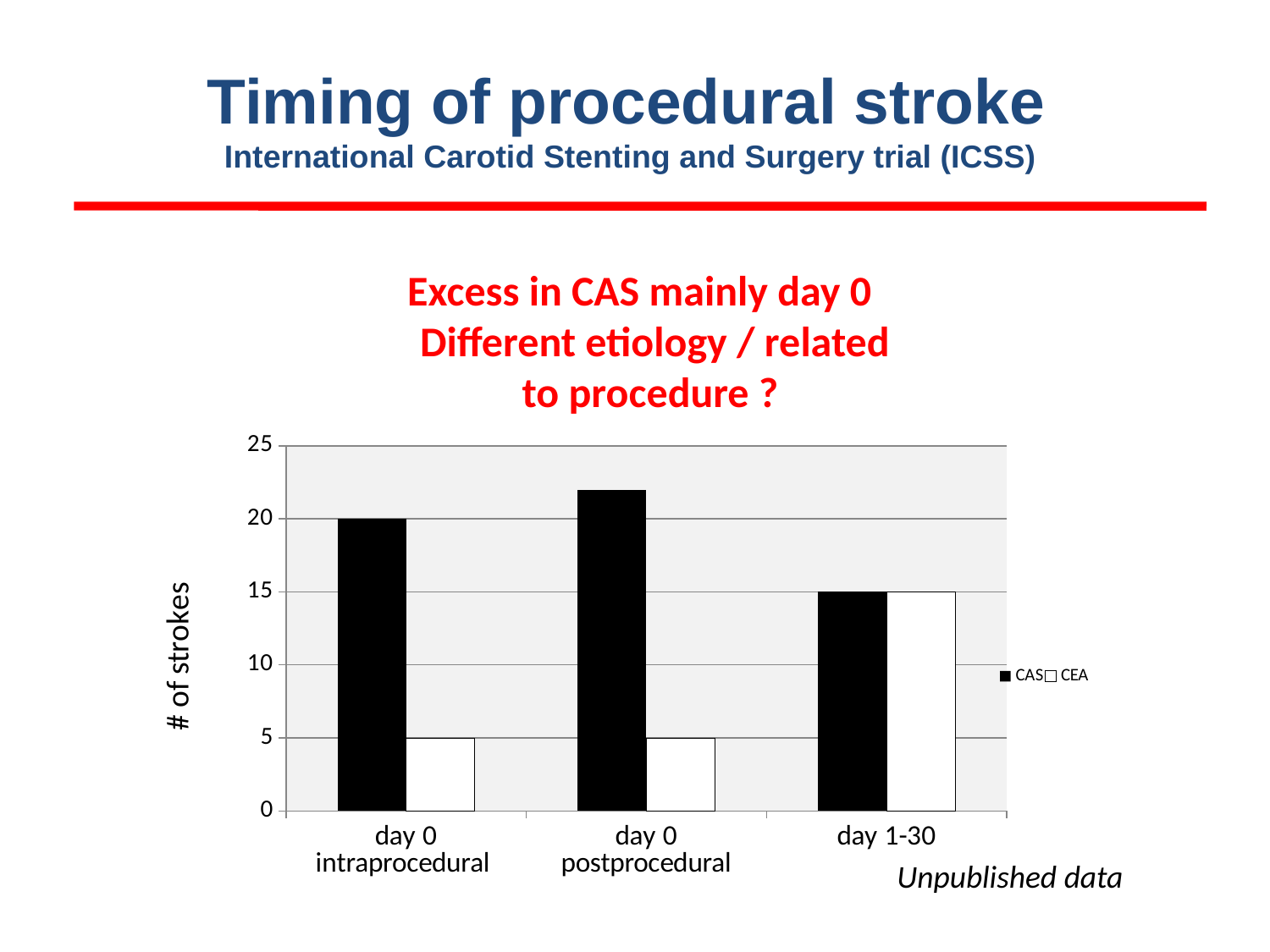
What is the number of strokes for CEA in the day 0 intraprocedural category? 5 In which category is the CAS value lowest? day 1-30 In the day 0 postprocedural category, which series has the larger value, CAS or CEA? CAS In which category is the CAS value highest? day 0 postprocedural What is the number of strokes for CEA in the day 1-30 category? 15 What is the label of the y axis? # of strokes How many series does the legend list? 2 What is the difference between the CAS and CEA values in the day 0 intraprocedural category? 15 Is the value for CAS in the day 0 postprocedural category greater or less than 20? greater How many categories are shown on the x axis? 3 What kind of chart is shown on the slide? bar chart What is the number of strokes for CAS in the day 0 intraprocedural category? 20